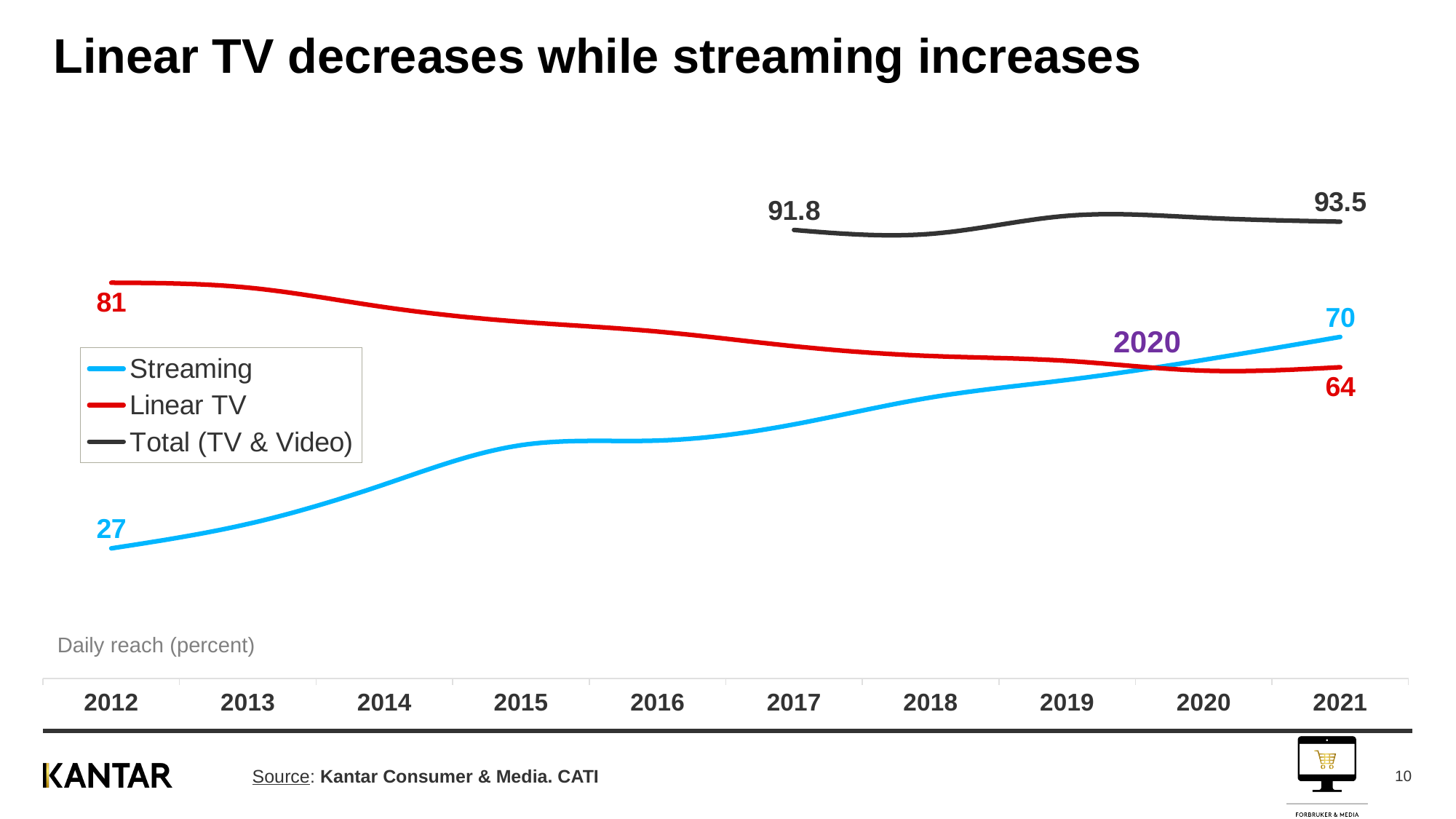
What is the value for Streaming in 2021? 70 What is the value for Streaming in 2012? 27 What is the value for Linear TV in 2012? 81 What kind of chart is shown on the slide? line chart Which is larger in 2021, Streaming or Linear TV? Streaming By how much did Streaming increase from 2012 to 2021? 43 What is the value for Total (TV & Video) in 2021? 93.5 Does the Linear TV line rise or fall from 2012 to 2021? fall How many series does the legend list? 3 What is the value for Linear TV in 2021? 64 By how much did Linear TV decrease from 2012 to 2021? 17 What is the value for Total (TV & Video) in 2017? 91.8